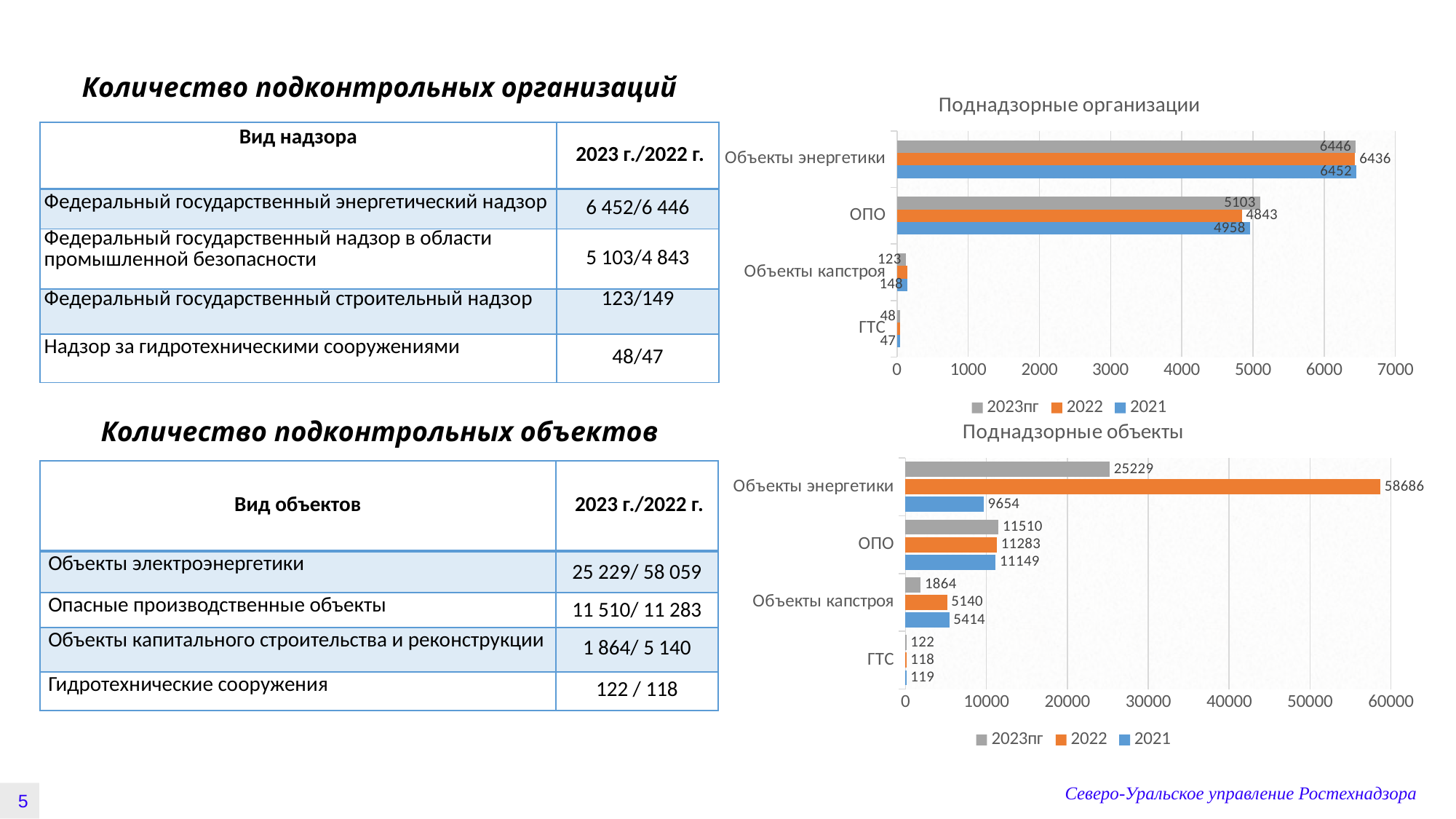
In the chart titled "Поднадзорные объекты", which is larger for Объекты энергетики: the 2023пг value or the 2021 value? 2023пг In the chart titled "Поднадзорные организации", what is the difference between the 2023пг and 2022 values for ОПО? 260 In the chart titled "Поднадзорные организации", what is the value for Объекты энергетики in the 2021 series? 6452 What kind of chart is the chart titled "Поднадзорные объекты"? bar chart In the chart titled "Поднадзорные объекты", what is the value for Объекты энергетики in the 2022 series? 58686 In the chart titled "Поднадзорные объекты", what is the difference between the 2022 and 2023пг values for Объекты капстроя? 3276 In the chart titled "Поднадзорные организации", which category has the lowest value in the 2023пг series? ГТС In the chart titled "Поднадзорные объекты", is the 2022 value for Объекты энергетики greater or less than 50000? greater In the chart titled "Поднадзорные объекты", which category has the highest value in the 2022 series? Объекты энергетики In the chart titled "Поднадзорные организации", what is the value for ОПО in the 2022 series? 4843 In the chart titled "Поднадзорные объекты", what is the value for ОПО in the 2023пг series? 11510 How many series does the legend of the chart titled "Поднадзорные организации" list? 3